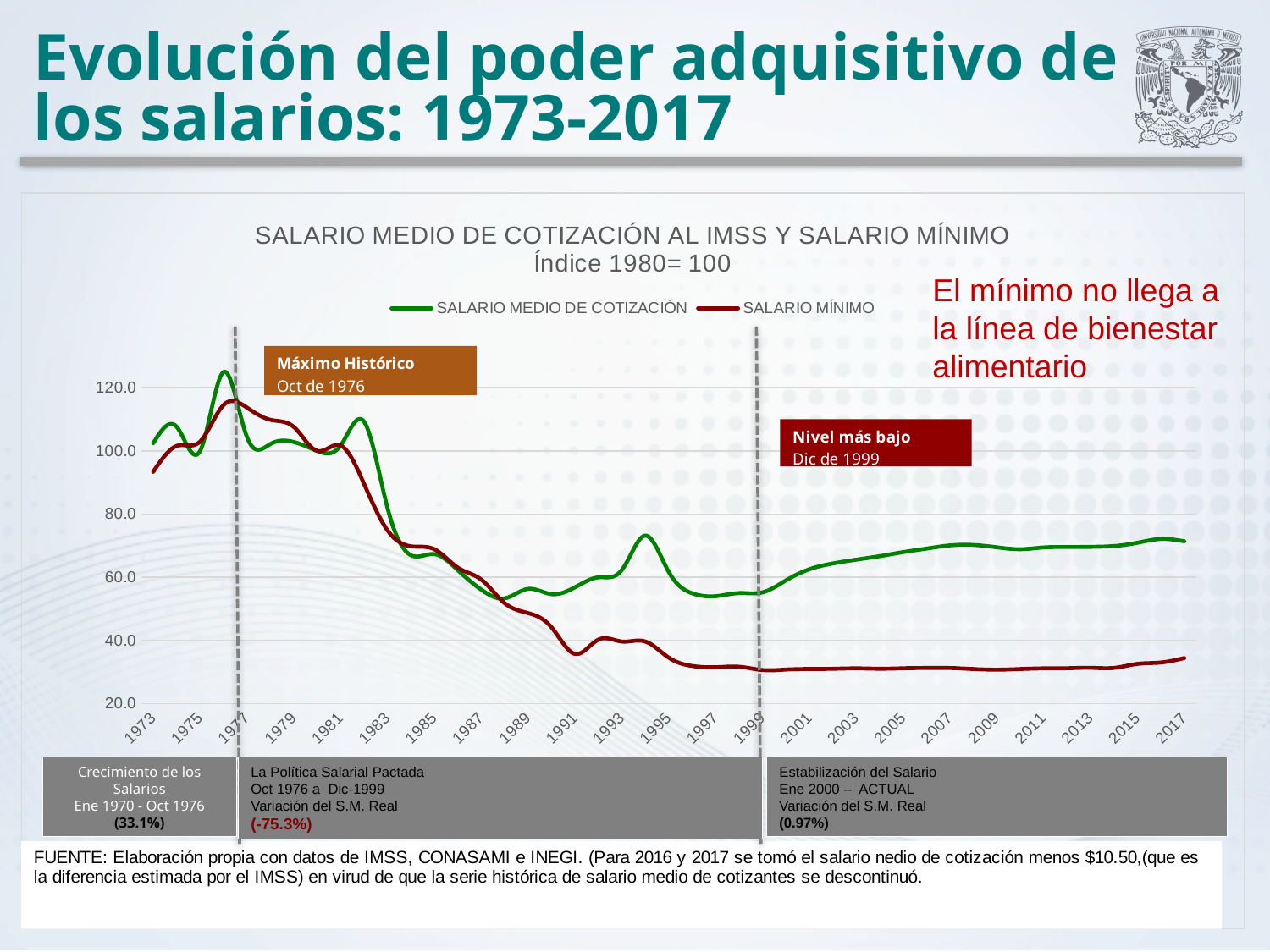
Is the value of SALARIO MÍNIMO in 1999 greater or less than 40.0? less Does the SALARIO MEDIO DE COTIZACIÓN series rise or fall between 1999 and 2017? rise How many series does the chart legend list? 2 What is the base year of the index used in the chart, according to the subtitle? 1980 = 100 What kind of chart is shown on the slide? line chart Is the value of SALARIO MEDIO DE COTIZACIÓN in 1983 greater or less than 100.0? less Is the value of SALARIO MEDIO DE COTIZACIÓN in 2017 greater or less than 60.0? greater In 2017, which series has the higher value, SALARIO MEDIO DE COTIZACIÓN or SALARIO MÍNIMO? SALARIO MEDIO DE COTIZACIÓN How many year labels are shown on the x axis of the chart? 23 What are the two series named in the chart legend? SALARIO MEDIO DE COTIZACIÓN and SALARIO MÍNIMO Does the SALARIO MÍNIMO series rise or fall between 1977 and 1999? fall